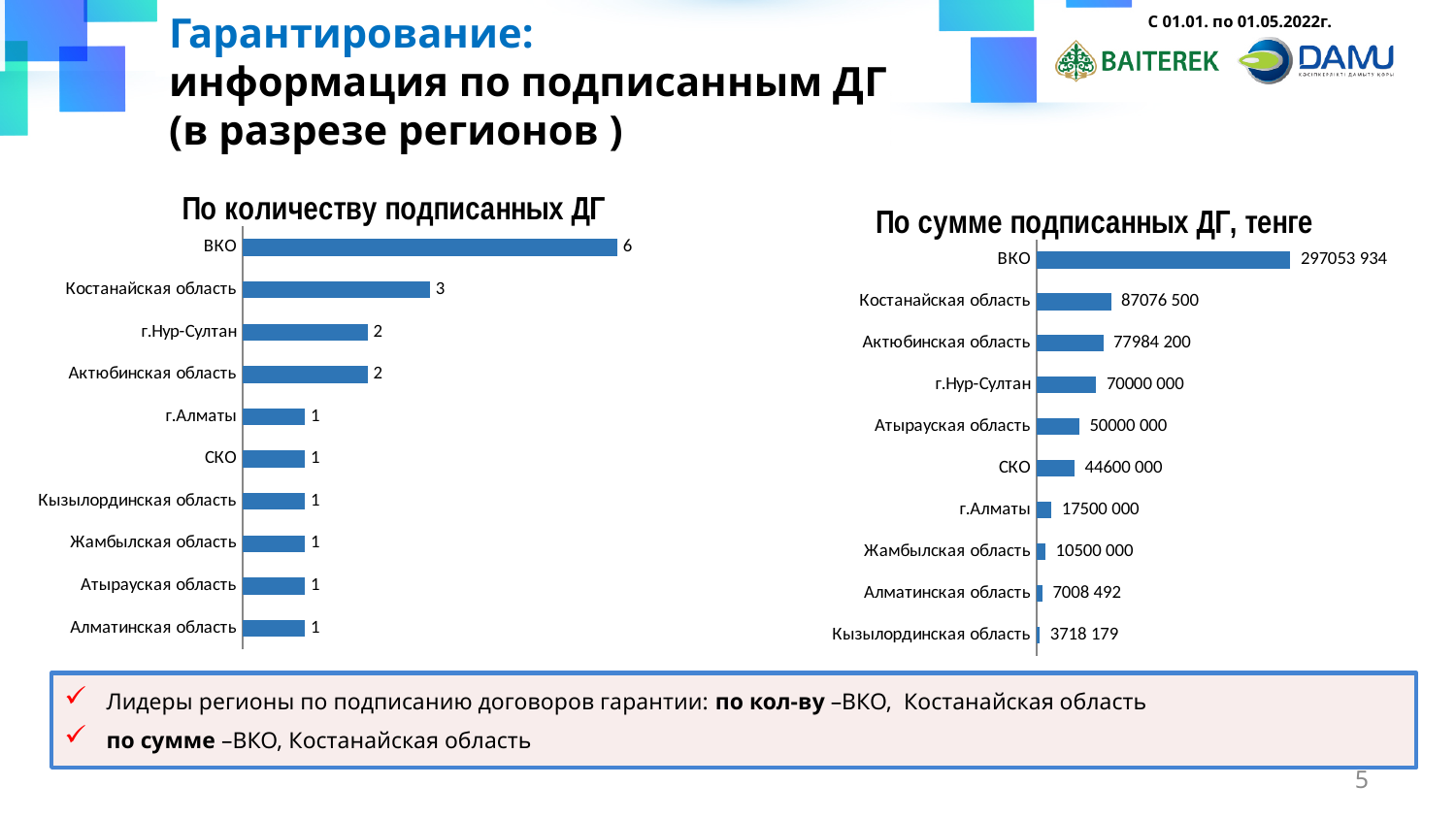
In the chart 'По сумме подписанных ДГ, тенге', what is the value for ВКО? 297053 934 In the chart 'По количеству подписанных ДГ', what is the value for ВКО? 6 In the chart 'По количеству подписанных ДГ', what is the value for Костанайская область? 3 In the chart 'По сумме подписанных ДГ, тенге', which is larger: г.Нур-Султан or Атырауская область? г.Нур-Султан In the chart 'По сумме подписанных ДГ, тенге', what is the value for Актюбинская область? 77984 200 What type of chart is 'По сумме подписанных ДГ, тенге'? Bar chart In the chart 'По сумме подписанных ДГ, тенге', what is the value for СКО? 44600 000 In the chart 'По количеству подписанных ДГ', which region has the highest value? ВКО In the chart 'По сумме подписанных ДГ, тенге', which region has the lowest value? Кызылординская область In the chart 'По сумме подписанных ДГ, тенге', what is the value for Кызылординская область? 3718 179 In the chart 'По количеству подписанных ДГ', how many regions are shown? 10 In the chart 'По количеству подписанных ДГ', what is the difference between ВКО and Костанайская область? 3